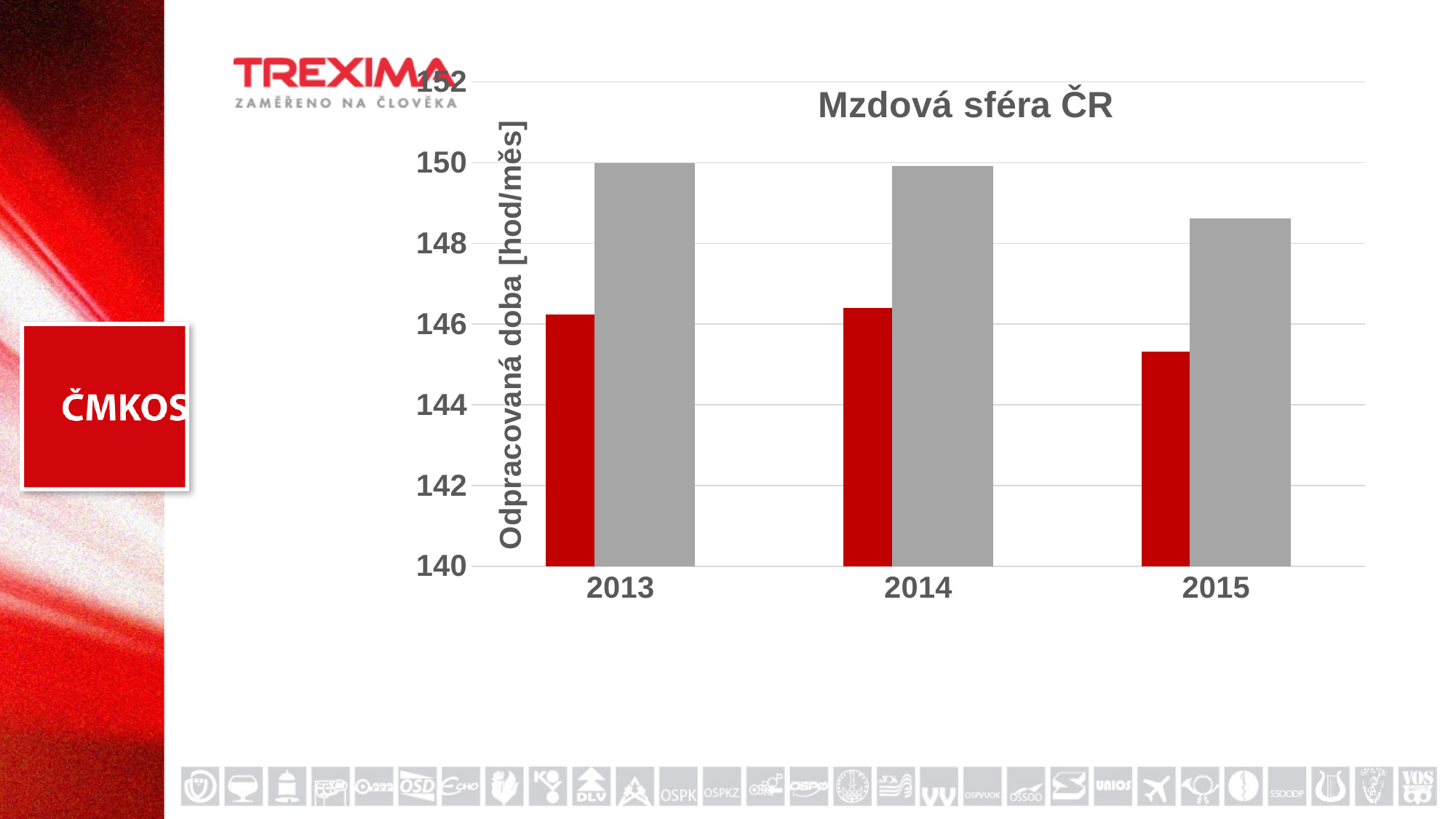
Among the grey bars, which year has the lowest value? 2015 Is the value of the grey bar for 2015 greater or less than 148? greater Do the grey bars rise or fall from 2013 to 2015? fall How many years are shown on the x axis? 3 What is the title of the chart? Mzdová sféra ČR In 2015, which bar is taller, the red one or the grey one? the grey one Is the value of the red bar for 2015 greater or less than 146? less Among the red bars, which year has the lowest value? 2015 How many bars are plotted for each year? 2 What is the label of the vertical axis? Odpracovaná doba [hod/měs] What kind of chart is shown on the slide? bar chart In 2013, which bar is taller, the red one or the grey one? the grey one